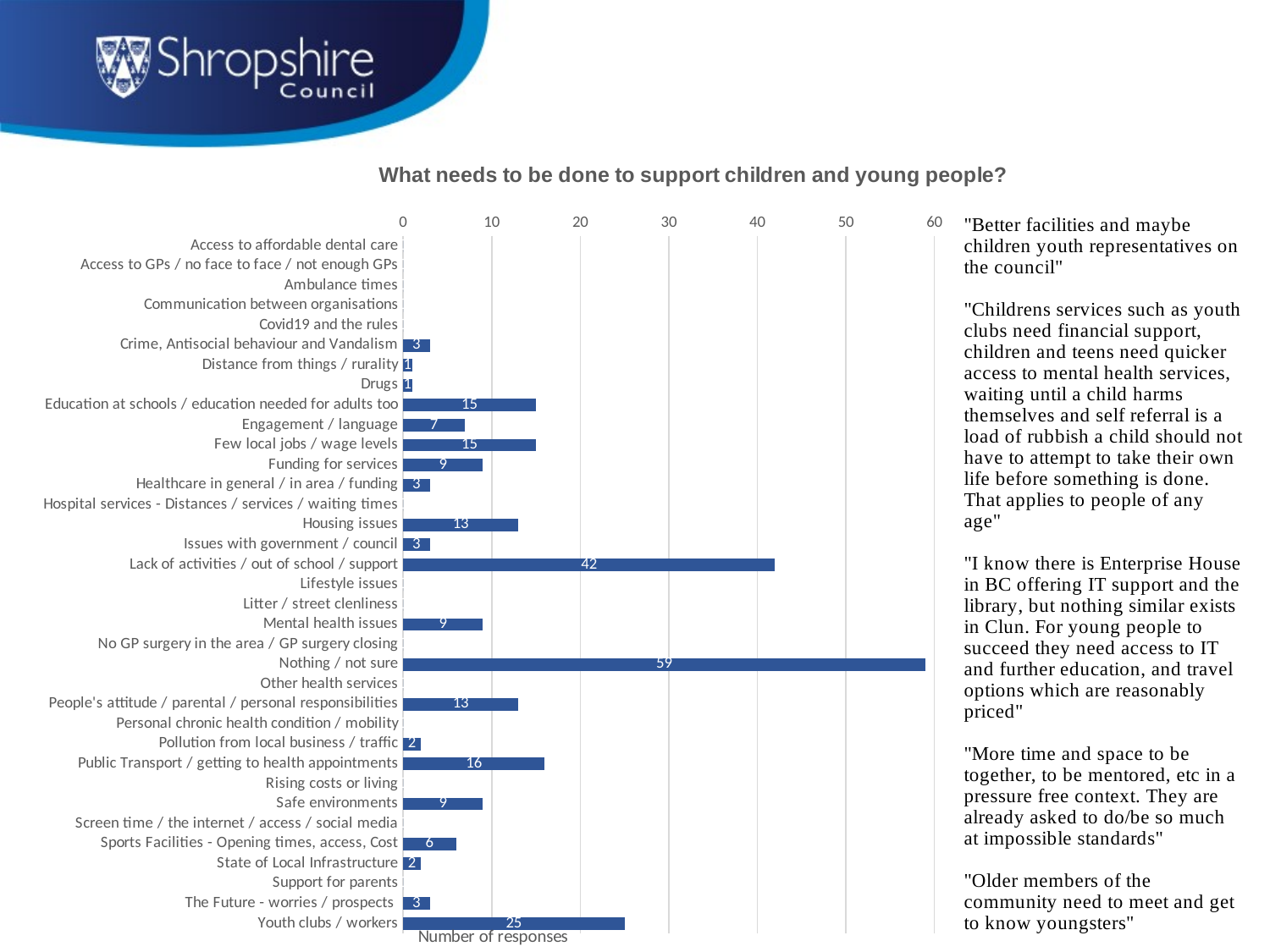
Which category has the highest number of responses? Nothing / not sure Is the value for "Lack of activities / out of school / support" greater or less than 40? greater What is the number of responses for "Youth clubs / workers"? 25 What is the number of responses for "Public Transport / getting to health appointments"? 16 What type of chart is shown on the slide? bar chart What is the difference in responses between "Nothing / not sure" and "Lack of activities / out of school / support"? 17 What is the number of responses for "Lack of activities / out of school / support"? 42 What is the title of the chart? What needs to be done to support children and young people? What is the label of the x axis? Number of responses What is the number of responses for "Nothing / not sure"? 59 What is the difference in responses between "Youth clubs / workers" and "Sports Facilities - Opening times, access, Cost"? 19 Which has more responses, "Housing issues" or "Youth clubs / workers"? Youth clubs / workers